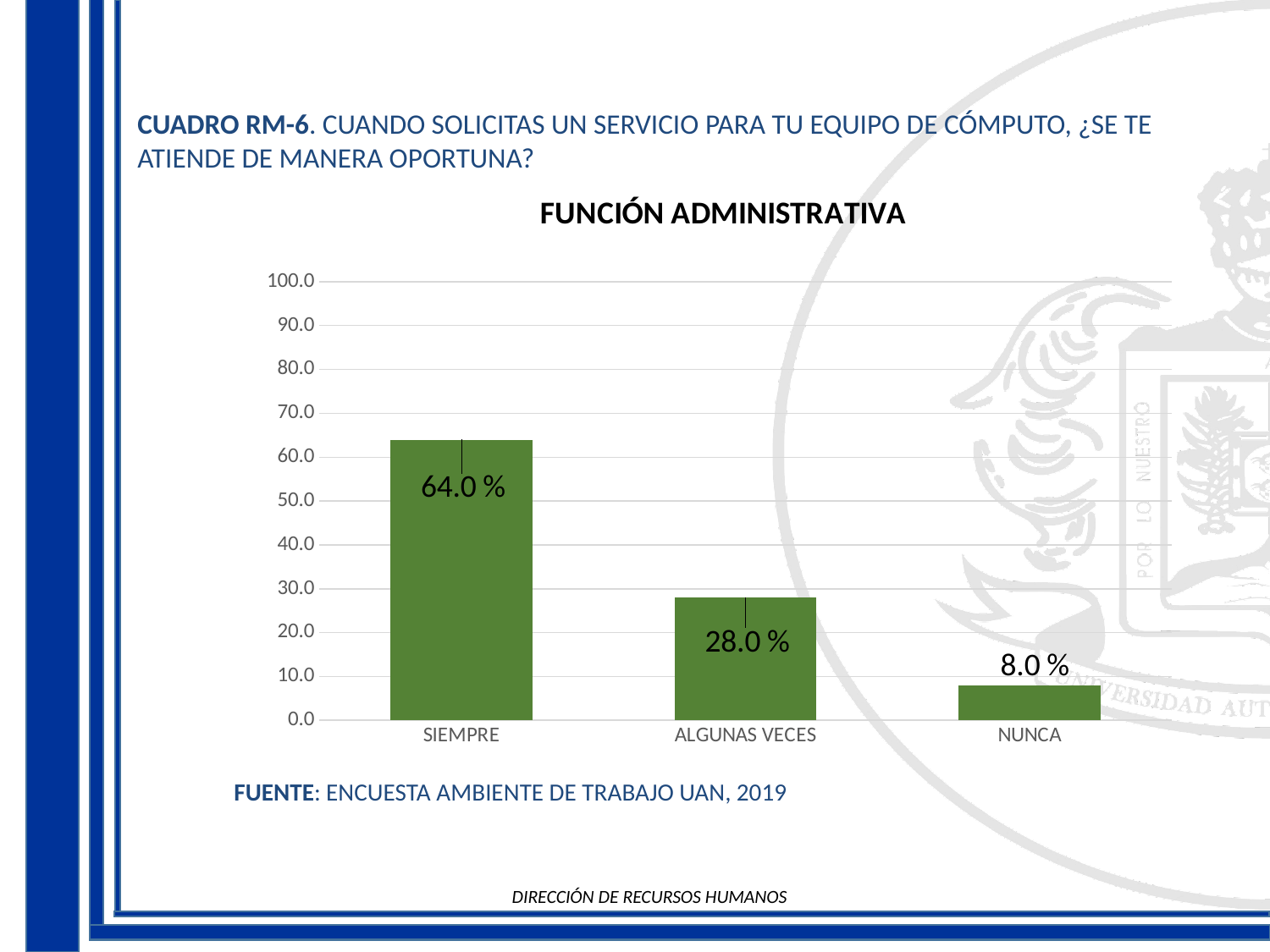
Which is larger, the value for ALGUNAS VECES or the value for NUNCA? ALGUNAS VECES What is the difference between the values for ALGUNAS VECES and NUNCA? 20.0 % What is the value for NUNCA? 8.0 % Which category has the lowest value? NUNCA Which category has the highest value? SIEMPRE What is the difference between the values for SIEMPRE and ALGUNAS VECES? 36.0 % How many categories are shown on the x axis? 3 What is the title of the chart? FUNCIÓN ADMINISTRATIVA What kind of chart is shown on the slide? bar chart What is the value for ALGUNAS VECES? 28.0 % What is the value for SIEMPRE? 64.0 % Is the value for SIEMPRE greater or less than 50.0? greater